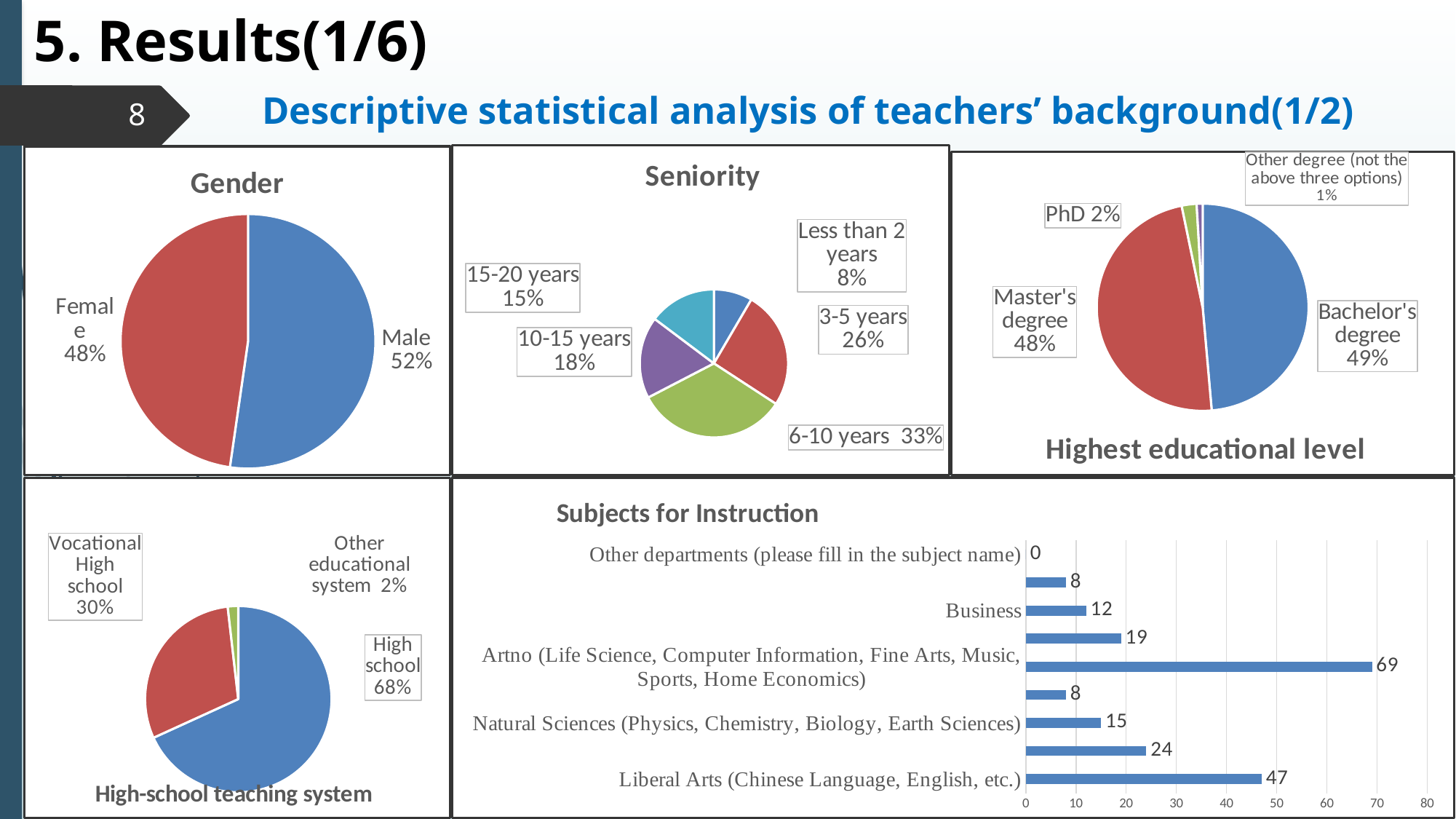
In the Subjects for Instruction chart, what is the value for Artno (Life Science, Computer Information, Fine Arts, Music, Sports, Home Economics)? 69 How many categories does the Seniority pie chart show? 5 What kind of chart is the Subjects for Instruction chart? bar chart In the High-school teaching system pie chart, what share is Vocational High school? 30% In the Seniority pie chart, which category has the smallest share? Less than 2 years In the Seniority pie chart, which category has the largest share? 6-10 years In the Gender pie chart, what share is Male? 52% What kind of chart is the Gender chart? pie chart In the Highest educational level pie chart, what is the difference between the Bachelor's degree share and the Master's degree share? 1% In the Seniority pie chart, what share is 6-10 years? 33% In the Highest educational level pie chart, what share is Master's degree? 48% In the Subjects for Instruction chart, which is larger, the value for Business or the value for Natural Sciences (Physics, Chemistry, Biology, Earth Sciences)? Natural Sciences (Physics, Chemistry, Biology, Earth Sciences)